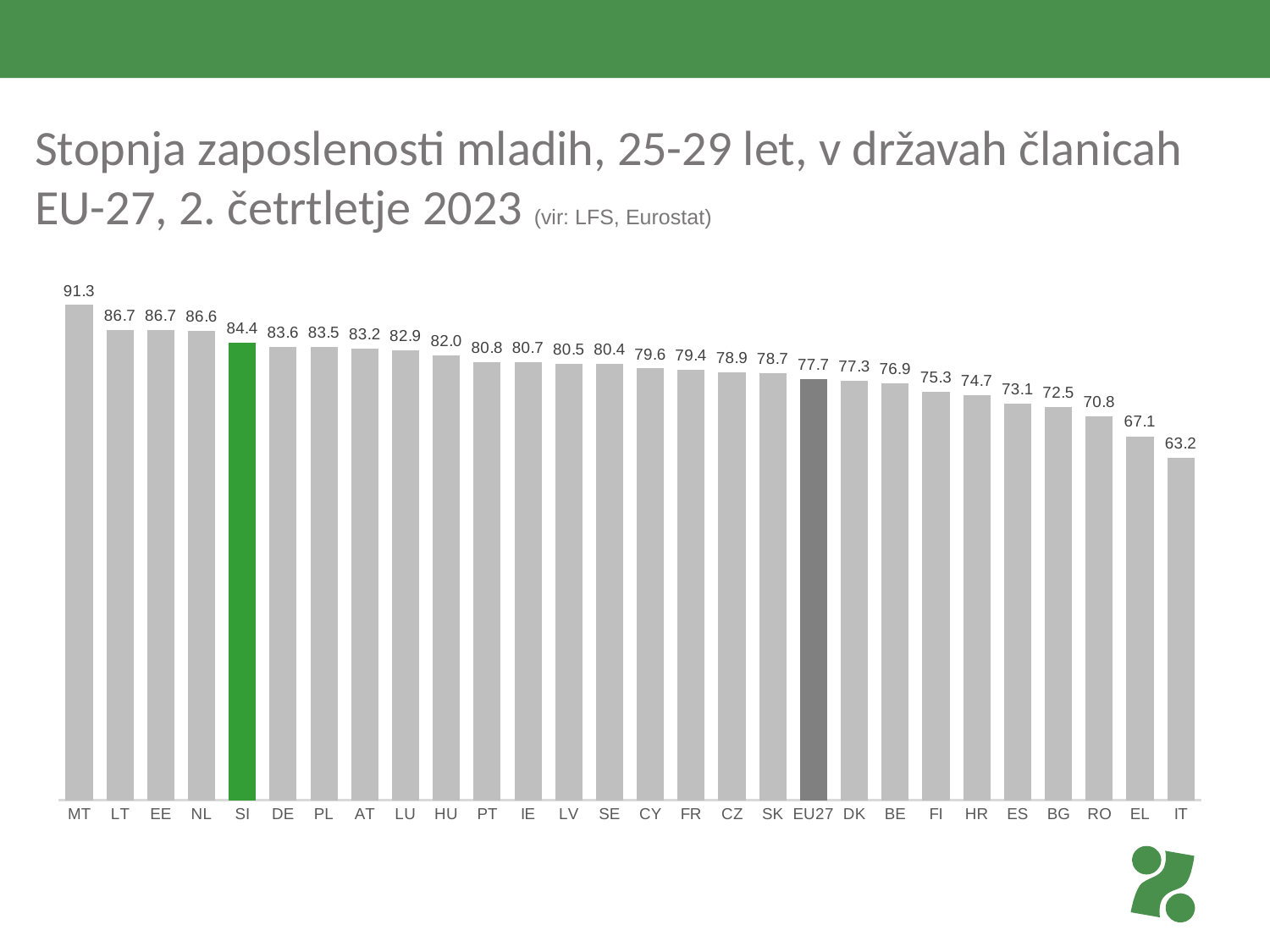
What is the difference between the values for SI and EU27? 6.7 Which category has the highest value? MT What is the value for SI? 84.4 Which bar is coloured green? SI What is the value for EU27? 77.7 Do the values rise or fall from left to right along the x axis? fall How many bars are shown in the chart? 28 Which category has the lowest value? IT What is the value for IT? 63.2 What kind of chart is shown on the slide? bar chart What is the difference between the values for MT and IT? 28.1 Which is larger, the value for DE or the value for FR? DE